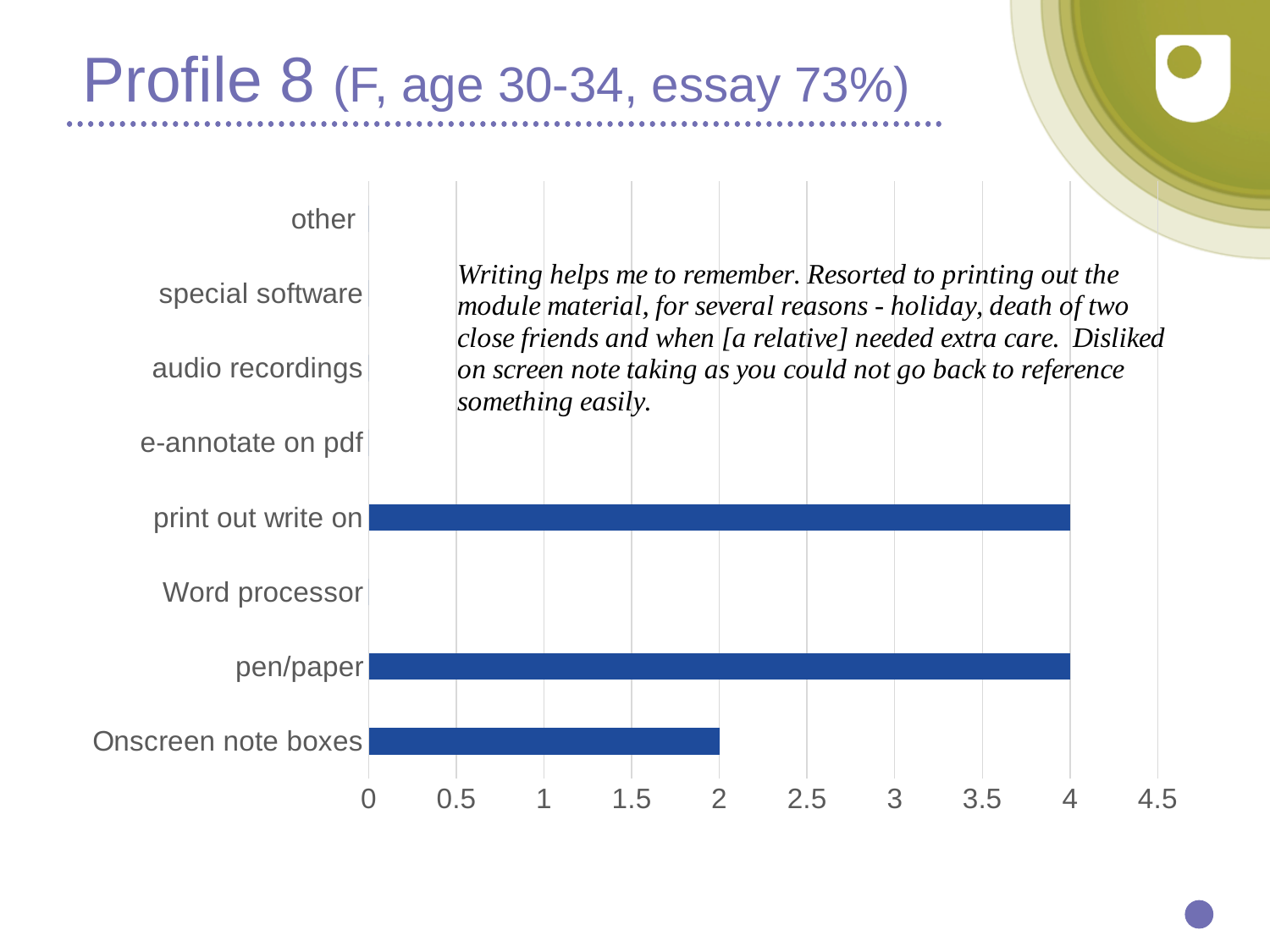
What is the value for print out write on? 4 Among the categories that have a bar, which has the shortest bar? Onscreen note boxes Is the value for pen/paper greater or less than 3? greater How many categories are listed on the vertical axis of the chart? 8 What kind of chart is shown on the slide? bar chart What is the difference between the values for pen/paper and Onscreen note boxes? 2 What is the value for pen/paper? 4 Is the value for Onscreen note boxes greater or less than 3? less Which is larger, the value for print out write on or the value for Onscreen note boxes? print out write on What colour are the bars in the chart? blue What is the value for Onscreen note boxes? 2 How many categories have a visible bar in the chart? 3